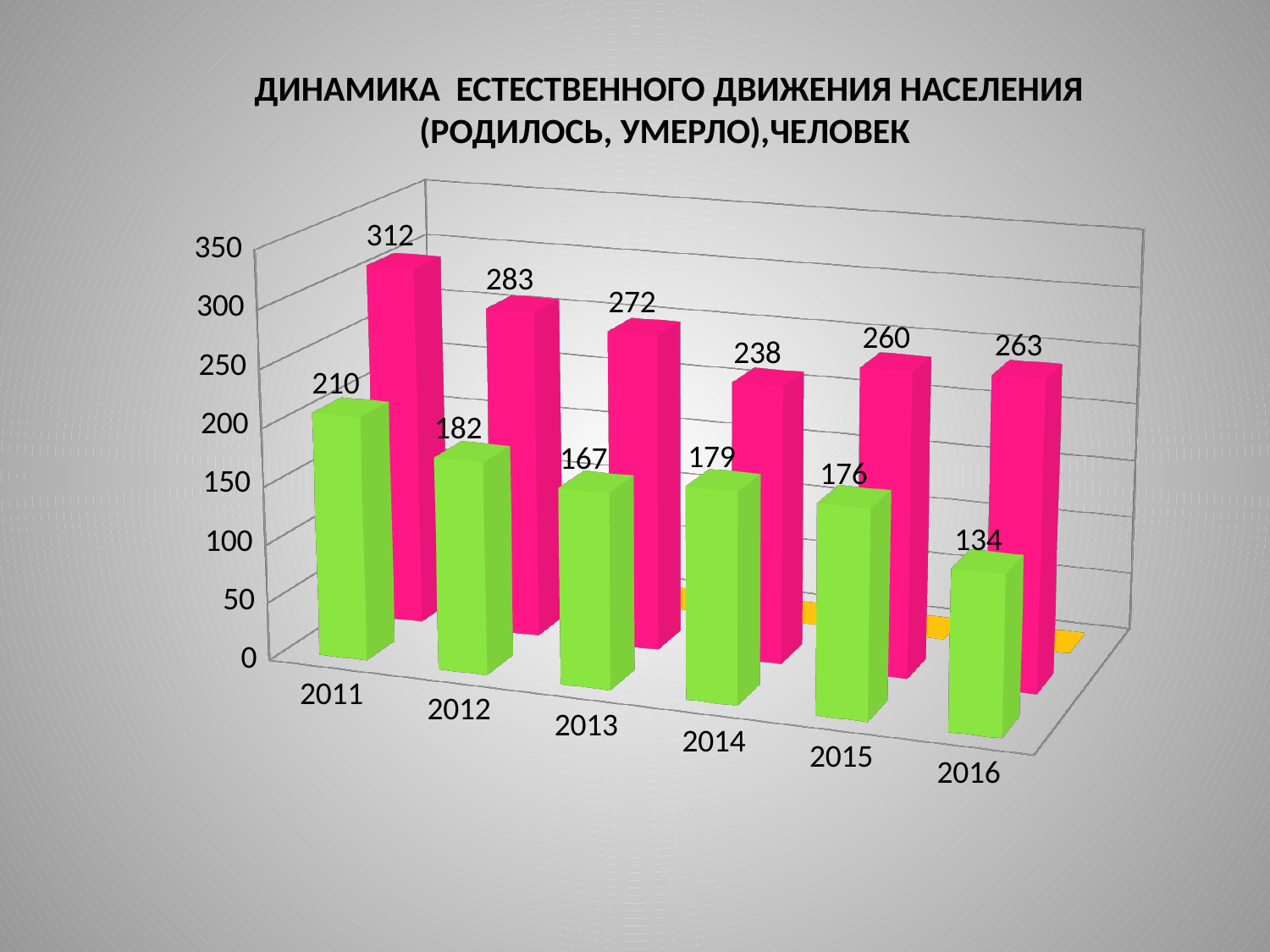
What is the difference between the pink bar values for 2011 and 2016? 49 What is the value of the green bar for 2016? 134 In which year is the green bar lowest? 2016 Which is larger, the green bar for 2014 or the green bar for 2015? 2014 What is the value of the pink bar for 2012? 283 How many years are shown on the x axis? 6 In which year is the pink bar highest? 2011 What is the difference between the pink bar and the green bar for 2013? 105 What is the value of the green bar for 2011? 210 Do the pink bar values generally rise or fall from 2011 to 2014? fall What is the value of the pink bar for 2014? 238 What kind of chart is shown on the slide? bar chart